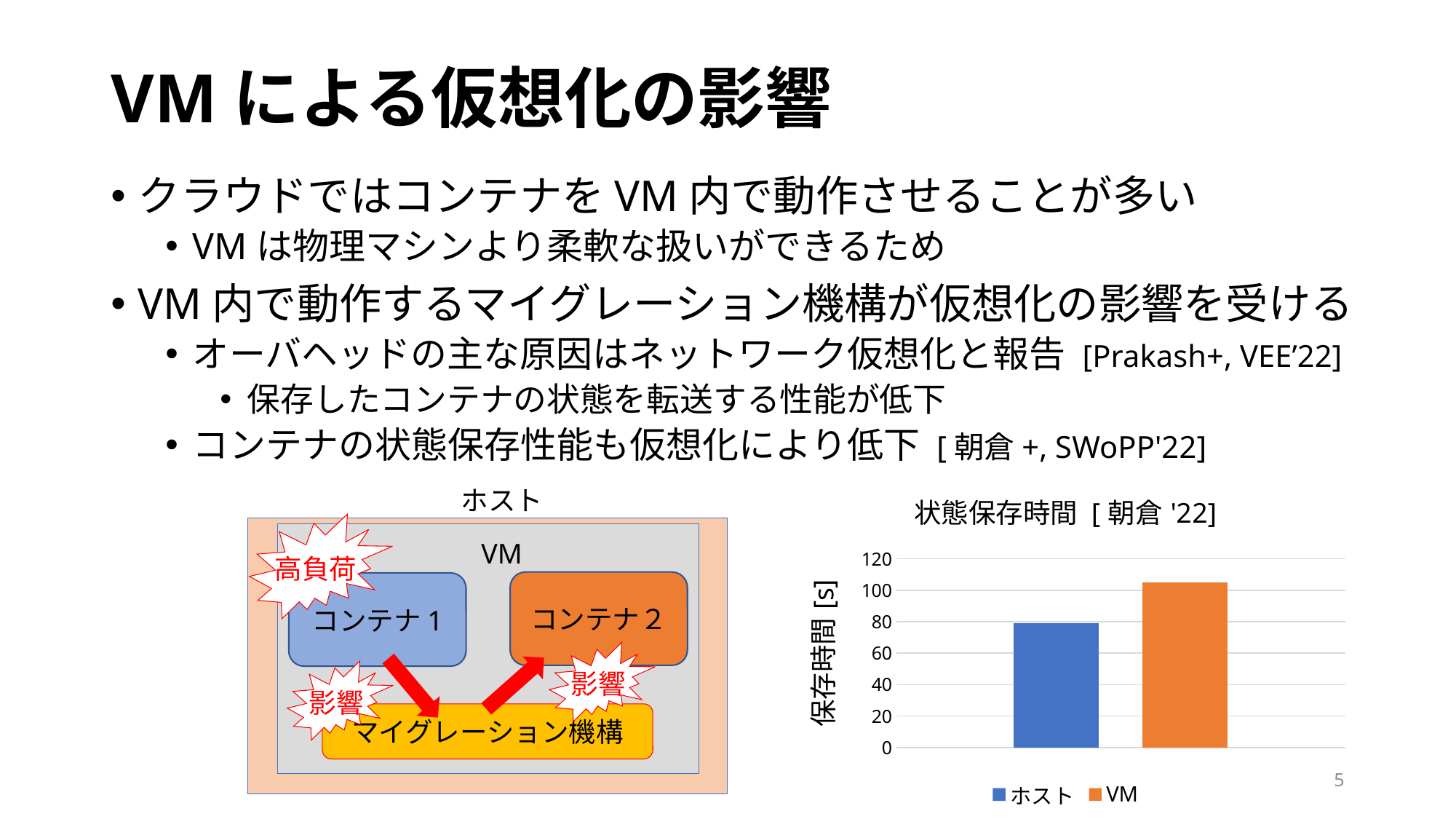
Is the value for VM greater or less than 100? greater How many series does the legend of the chart list? 2 Is the value for ホスト greater or less than 100? less What kind of chart is shown on the slide? bar chart Which series has the higher 保存時間 in the chart, ホスト or VM? VM Which bar in the chart is the tallest? VM What is the label of the vertical axis of the chart? 保存時間 [s] Is the value for VM greater or less than 120? less How many bars are plotted in the chart? 2 Which bar in the chart is the shortest? ホスト What is the title of the chart? 状態保存時間 [朝倉 '22]